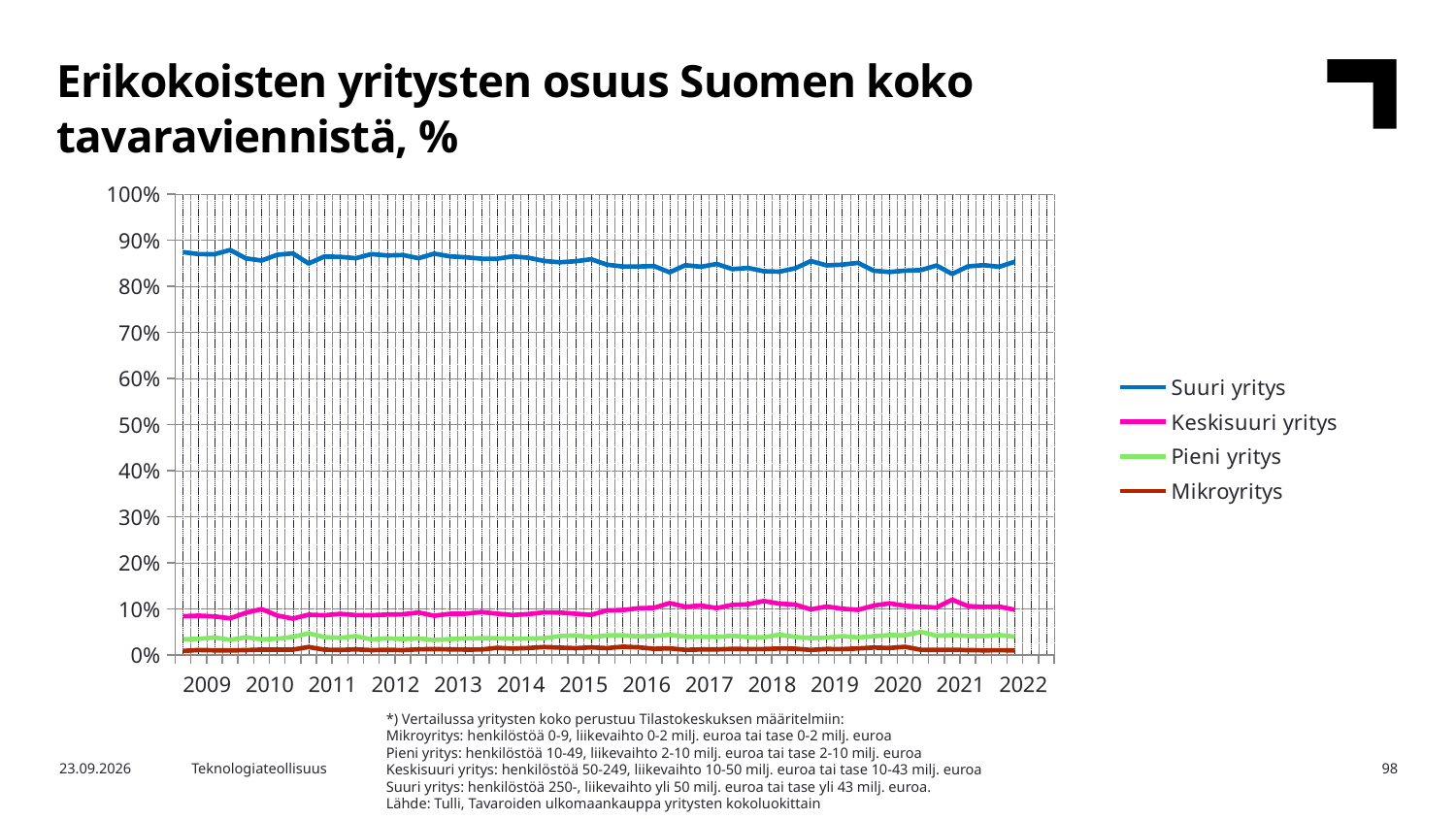
Which is larger in 2020, the value for Pieni yritys or the value for Mikroyritys? Pieni yritys How many years are labelled on the x axis? 14 Which series has the highest values throughout the chart? Suuri yritys Which is larger in 2018, the value for Suuri yritys or the value for Keskisuuri yritys? Suuri yritys Is the value for Suuri yritys in 2022 greater or less than 80%? greater What colour is the line for Keskisuuri yritys? Magenta (pink) Is the value for Pieni yritys in 2015 greater or less than 10%? less Which series has the lowest values throughout the chart? Mikroyritys Is the value for Keskisuuri yritys in 2022 greater or less than 20%? less What kind of chart is shown on the slide? Line chart How many series does the legend list? 4